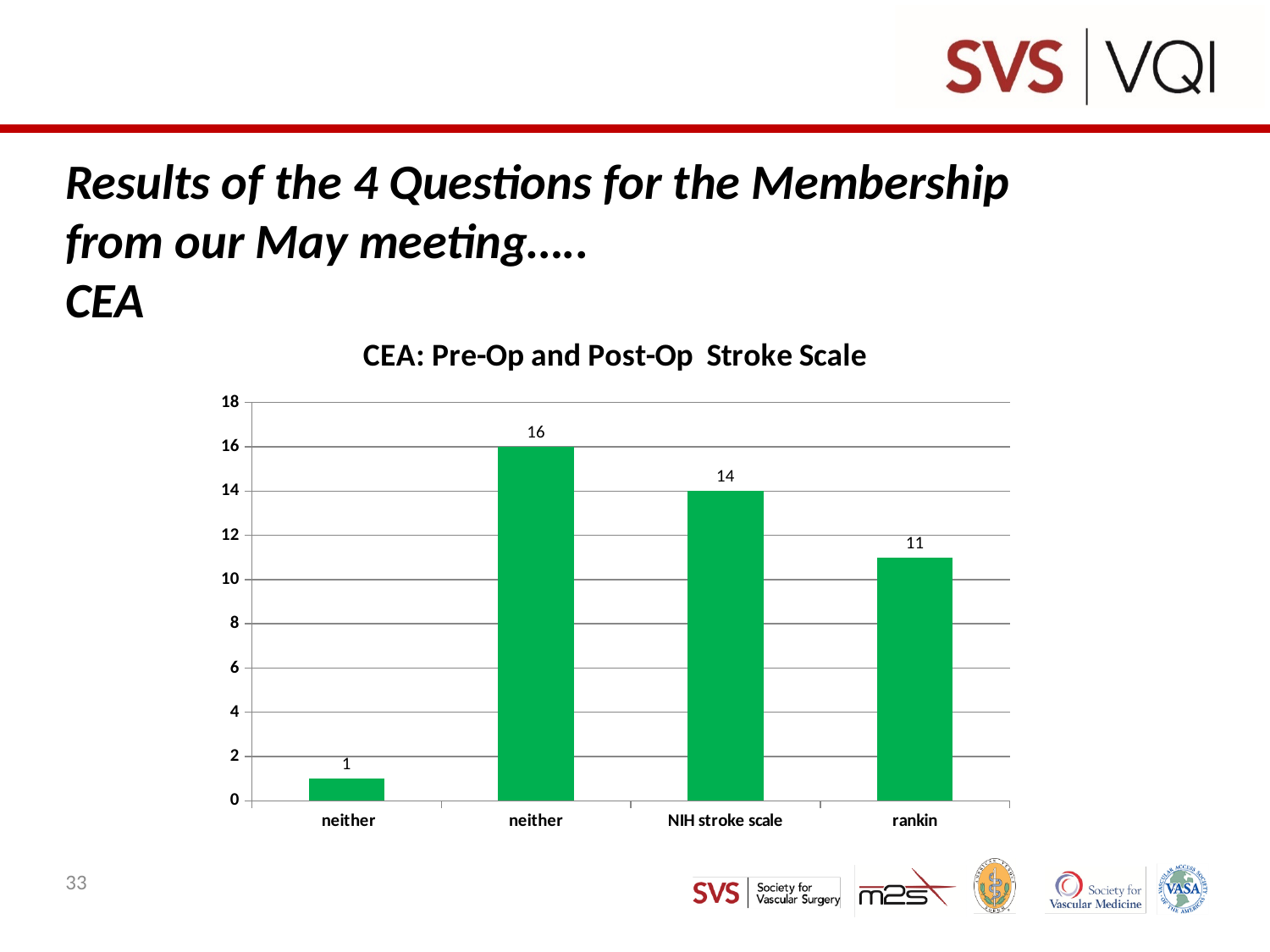
What is the value for rankin? 11 What is the value for NIH stroke scale? 14 What is the value of the second bar from the left, labelled neither? 16 What is the difference between the values for NIH stroke scale and rankin? 3 How many bars are plotted in the chart? 4 Which is larger, the value for NIH stroke scale or the value for rankin? NIH stroke scale What kind of chart is shown on the slide? bar chart What colour are the bars in the chart? green Which category has the lowest value? neither (the first bar) What is the value of the first bar on the left, labelled neither? 1 What is the title of the chart? CEA: Pre-Op and Post-Op Stroke Scale What is the highest value shown in the chart? 16